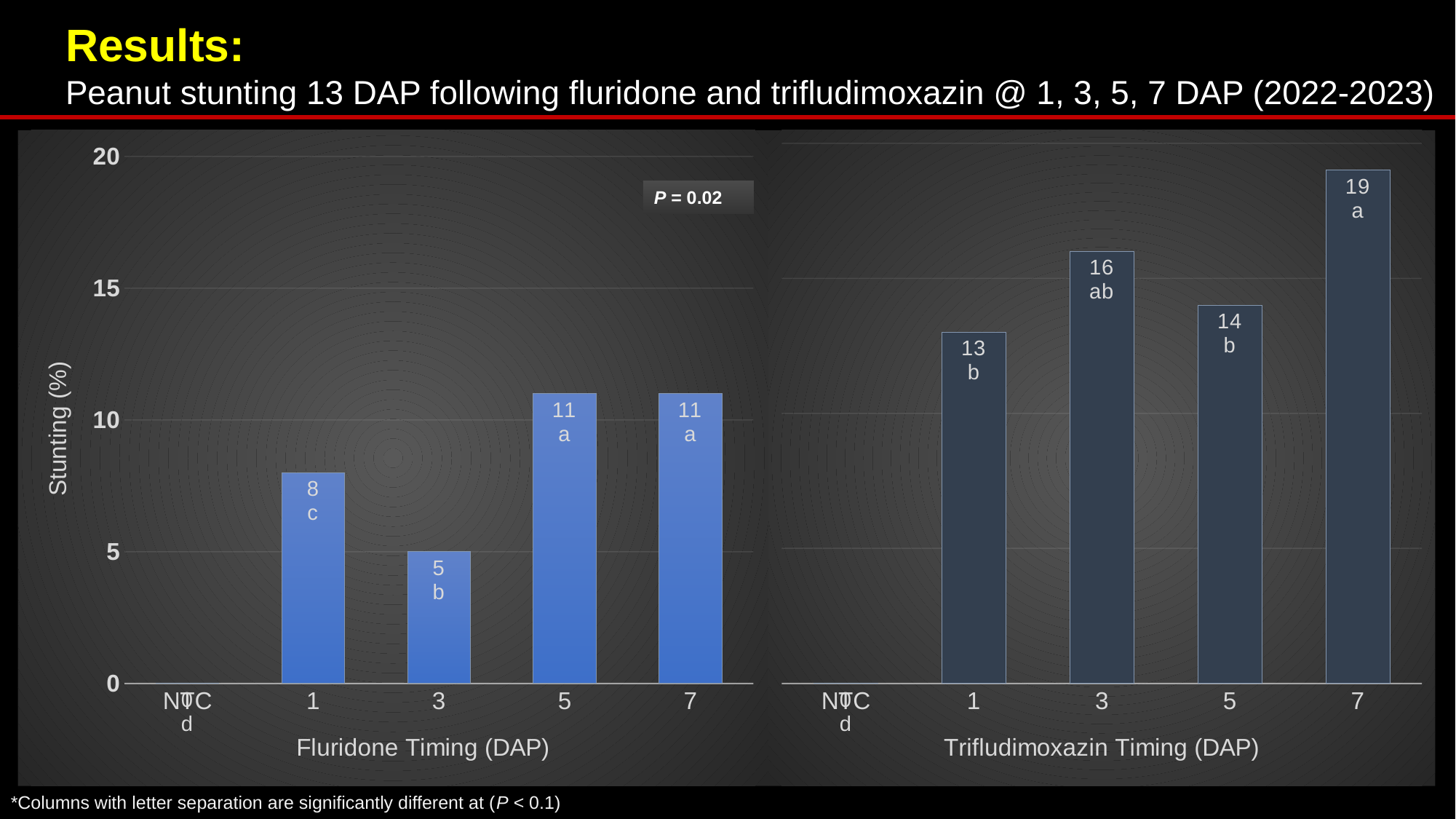
What type of chart is used for the Trifludimoxazin Timing chart on the right? Bar chart In the Fluridone Timing chart on the left, which timing (excluding NTC) has the lowest stunting? 3 In the Trifludimoxazin Timing chart on the right, which timing has the highest stunting? 7 In the Trifludimoxazin Timing chart on the right, what is the difference in stunting between the 7 DAP and 1 DAP timings? 6 In the Trifludimoxazin Timing chart on the right, is the stunting value for the 1 DAP timing greater or less than 10? greater How many categories are shown on the x axis of the Fluridone Timing chart on the left? 5 In the Fluridone Timing chart on the left, what is the stunting value for the 3 DAP timing? 5 In the Fluridone Timing chart on the left, what is the stunting value for the 1 DAP timing? 8 In the Trifludimoxazin Timing chart on the right, what is the stunting value for the 7 DAP timing? 19 In the Trifludimoxazin Timing chart on the right, what is the stunting value for the 3 DAP timing? 16 In the Trifludimoxazin Timing chart on the right, which has higher stunting: the 3 DAP timing or the 5 DAP timing? 3 DAP In the Fluridone Timing chart on the left, what is the difference in stunting between the 5 DAP and 3 DAP timings? 6